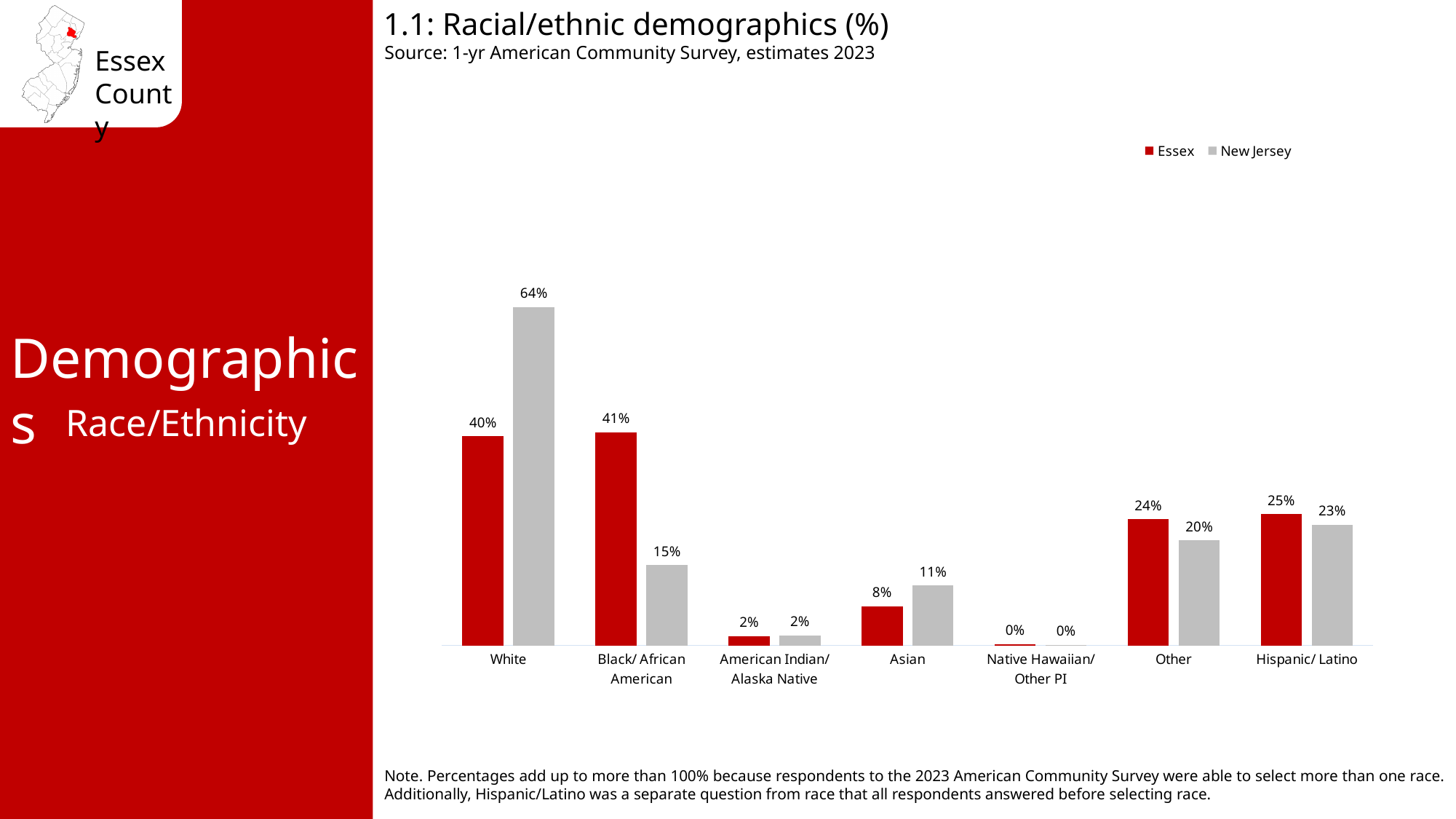
How many categories are shown on the x axis? 7 Which category has the highest New Jersey value? White What is the difference between the Essex and New Jersey values for Black/ African American? 26% What is the New Jersey value for Black/ African American? 15% How many series does the legend list? 2 What is the difference between the New Jersey and Essex values for White? 24% Which category has the highest Essex value? Black/ African American Which is larger for Asian, the Essex value or the New Jersey value? New Jersey What is the Essex value for Hispanic/ Latino? 25% Which is larger for Other, the Essex value or the New Jersey value? Essex What kind of chart is shown on the slide? Bar chart What is the Essex value for White? 40%